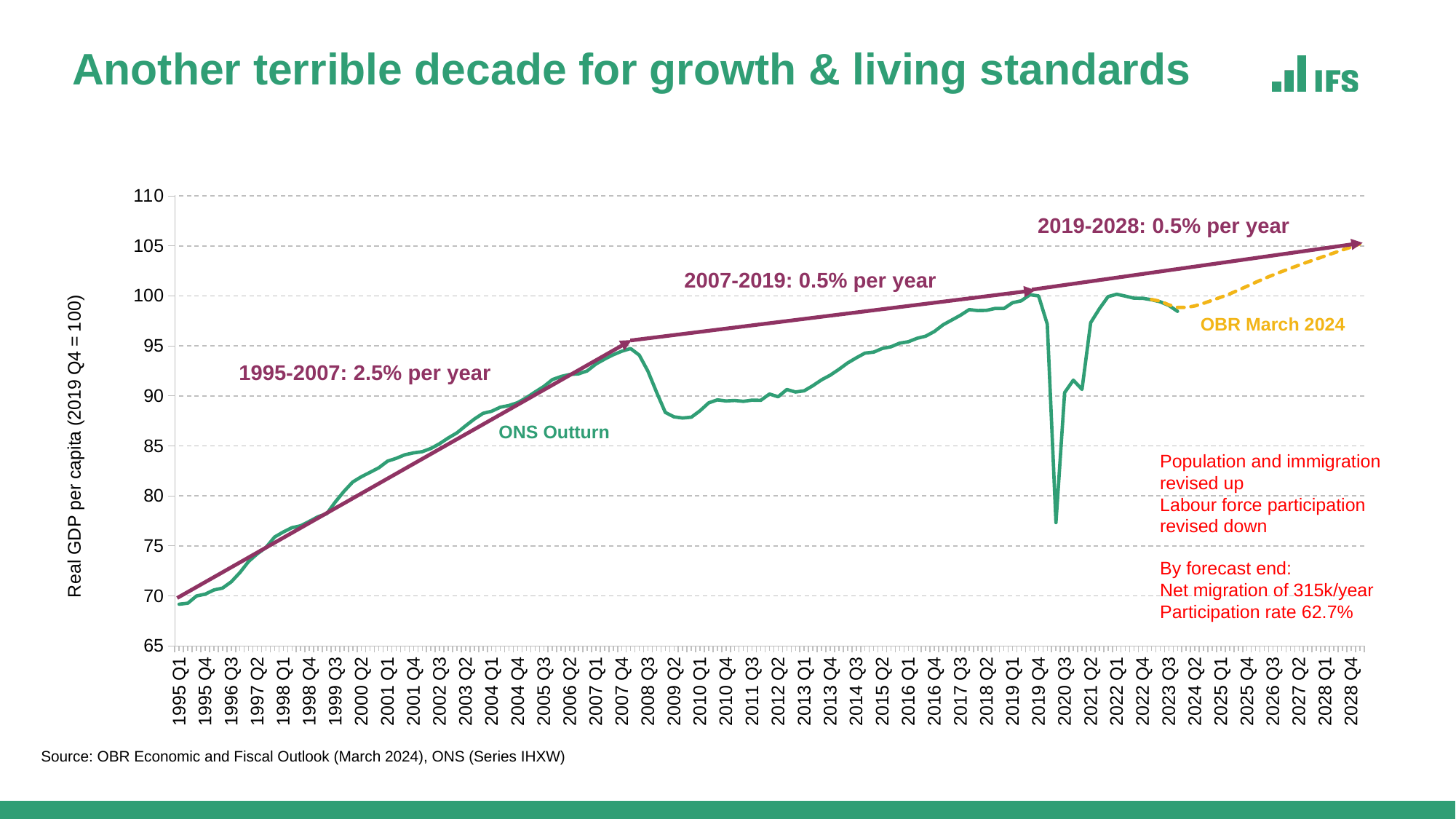
What is the annual growth rate shown for 2007-2019? 0.5% per year Which is higher, the ONS Outturn value in 2007 Q4 or in 2020 Q2? 2007 Q4 Is the ONS Outturn value in 2009 Q2 greater or less than 90? less Is the ONS Outturn value in 1995 Q1 greater or less than 70? less Is the ONS Outturn value in 2000 Q2 greater or less than 80? greater What is the annual growth rate shown for 1995-2007? 2.5% per year What kind of chart is shown on the slide? line chart What is the label of the dashed yellow forecast line? OBR March 2024 What is the annual growth rate shown for 2019-2028? 0.5% per year What is the index value of real GDP per capita in 2019 Q4, the base period? 100 Does the ONS Outturn line rise or fall between 1995 Q1 and 2007 Q4? rise